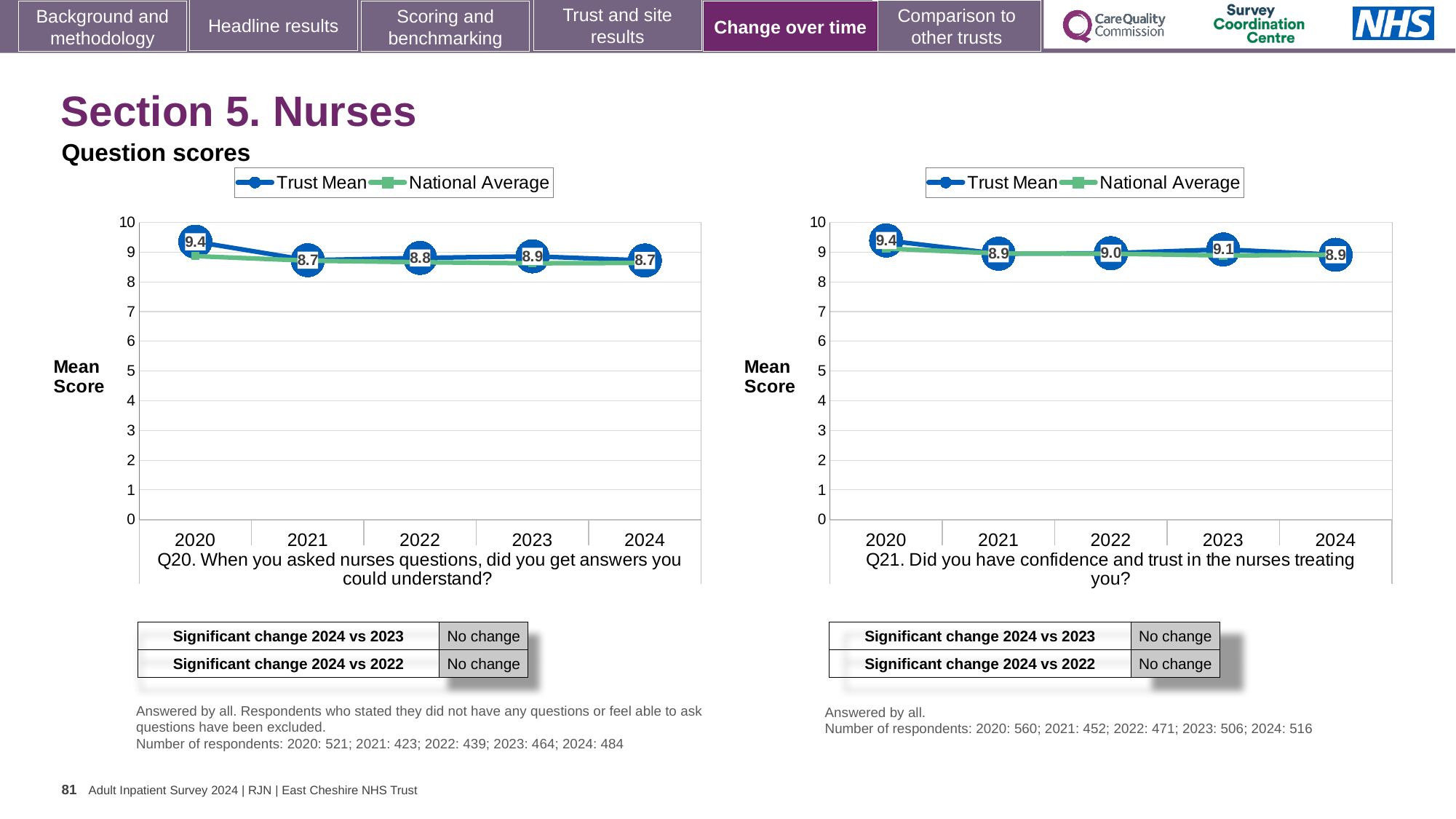
In the Q20 chart (left), does the Trust Mean rise or fall from 2020 to 2021? Fall In the Q21 chart (right), is the National Average for 2020 greater or less than 8? greater What type of chart is the Q20 chart (left)? Line chart How many series does the legend of the Q21 chart (right) list? 2 In the Q21 chart (right), what is the difference between the Trust Mean scores for 2023 and 2024? 0.2 In the Q21 chart (right), what is the Trust Mean score for 2023? 9.1 In the Q20 chart (left), what is the difference between the Trust Mean scores for 2020 and 2021? 0.7 In the Q20 chart (left), what is the Trust Mean score for 2020? 9.4 In the Q20 chart (left), what is the Trust Mean score for 2024? 8.7 In the Q20 chart (left), is the Trust Mean score higher in 2023 or in 2024? 2023 In the Q21 chart (right), which year has the highest Trust Mean score? 2020 How many years are plotted on the x axis of the Q20 chart (left)? 5